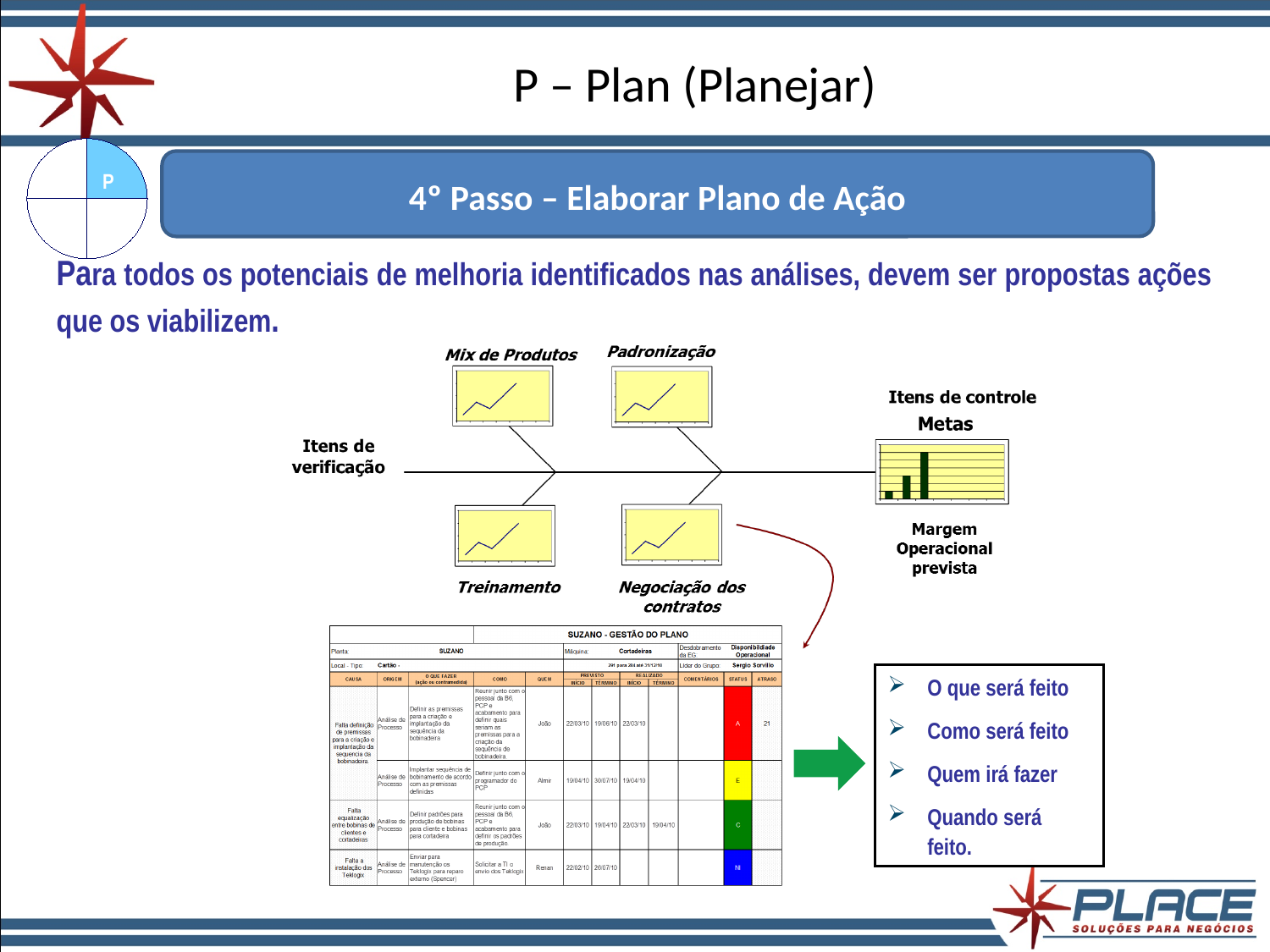
Which label is written to the left of the four line charts in the diagram? Itens de verificação How many small line charts are shown in the diagram on the slide? 4 In the "Itens de controle / Metas" bar chart, is the shortest bar on the left or the right? left What kind of chart is shown under the heading "Mix de Produtos"? line chart In the "Padronização" line chart, does the line overall rise or fall from left to right? rise What kind of chart is shown above the label "Treinamento"? line chart How many bars are plotted in the "Itens de controle / Metas" bar chart? 3 What kind of chart is shown under the heading "Itens de controle / Metas"? bar chart What label appears below the "Itens de controle / Metas" bar chart? Margem Operacional prevista In the "Itens de controle / Metas" bar chart, is the tallest bar on the left or the right? right In the "Itens de controle / Metas" bar chart, do the bars rise or fall from left to right? rise In the "Negociação dos contratos" line chart, does the line overall rise or fall from left to right? rise